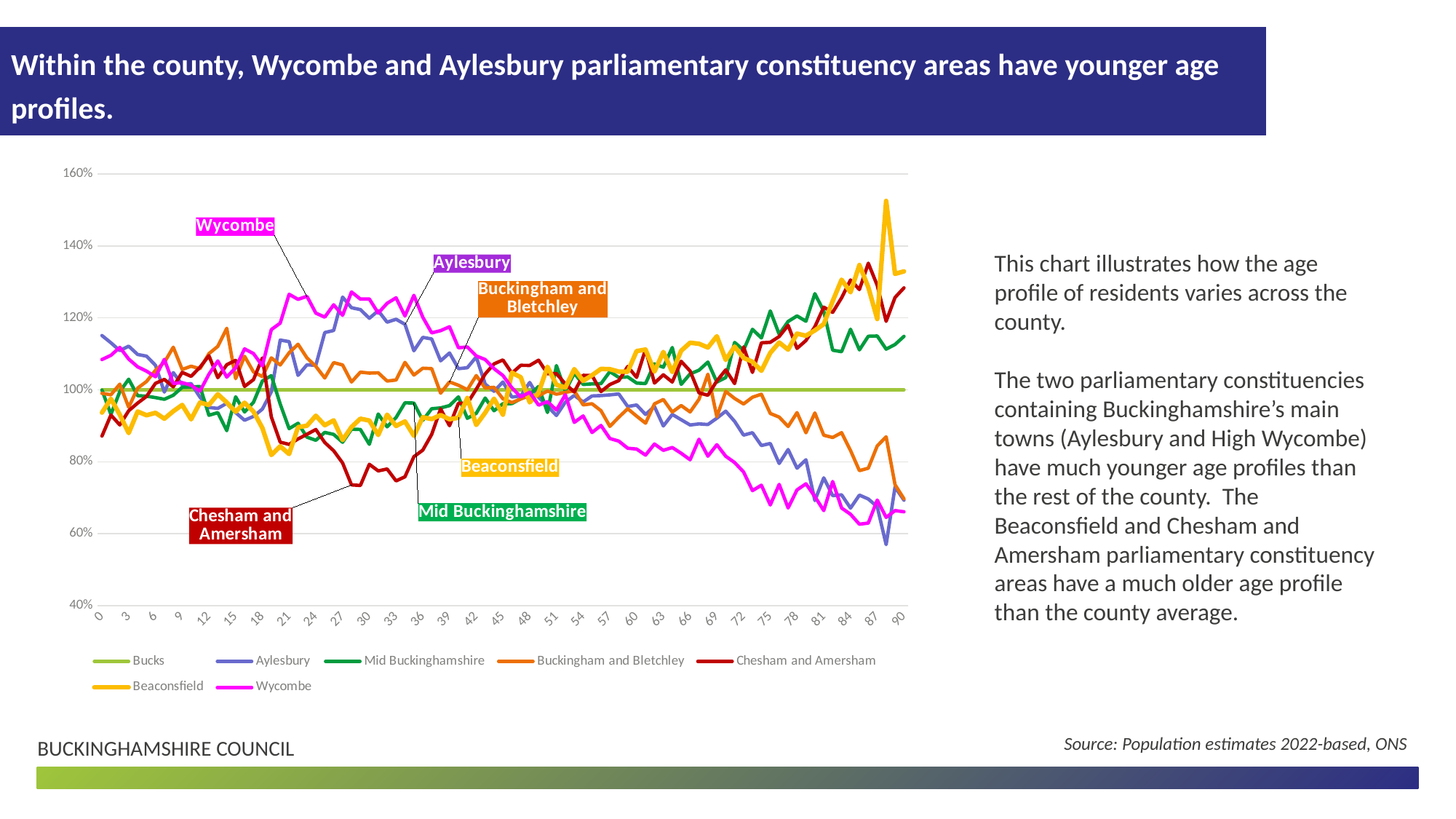
What colour is the Wycombe line? Magenta (pink) Which series reaches the highest value anywhere on the chart? Beaconsfield How many series does the legend list? 7 Which series is drawn as a flat line at 100% across all ages? Bucks Is the value for Beaconsfield at age 87 greater or less than 140%? less What kind of chart is shown on the slide? Line chart Is the value for Wycombe at age 87 greater or less than 80%? less At age 27, which is larger: the value for Wycombe or the value for Chesham and Amersham? Wycombe At age 87, which is larger: the value for Beaconsfield or the value for Wycombe? Beaconsfield Does the Wycombe line rise or fall between age 45 and age 90? Fall